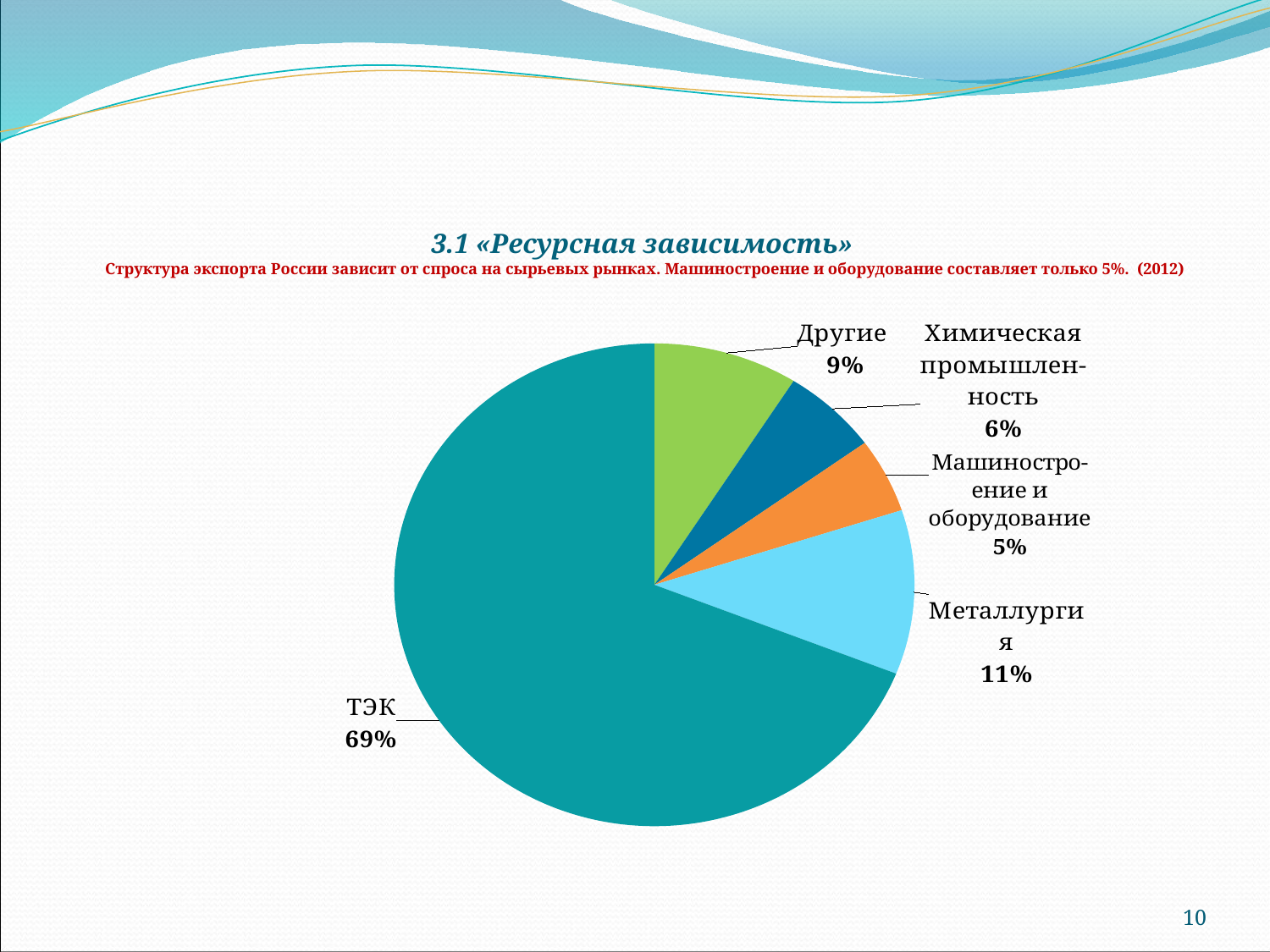
Which category has the smallest slice of the pie? Машиностроение и оборудование What kind of chart is shown on the slide? pie chart Which category has the largest slice of the pie? ТЭК What is the difference between the shares of ТЭК and Металлургия? 58% What share of the pie does Химическая промышленность have? 6% What share of the pie does Машиностроение и оборудование have? 5% What share of the pie does Другие have? 9% What share of the pie does Металлургия have? 11% What colour is the ТЭК slice? teal Which is larger, the share of Другие or the share of Химическая промышленность? Другие What share of the pie does ТЭК have? 69% How many slices does the pie chart have? 5